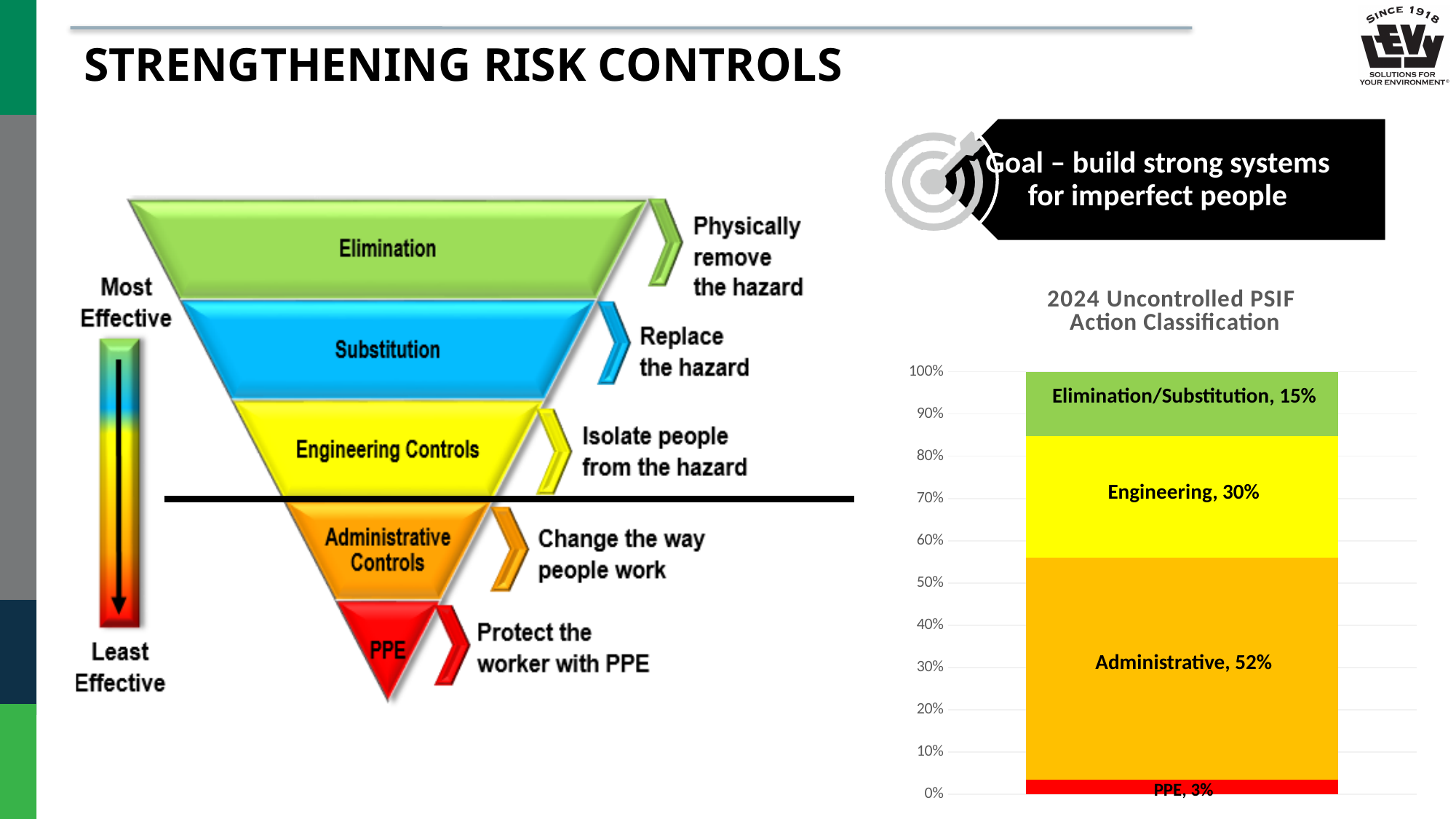
In the 2024 Uncontrolled PSIF Action Classification chart, which segment has the smallest share? PPE In the 2024 Uncontrolled PSIF Action Classification chart, what is the total of the Administrative and PPE segments? 55% What is the title of the chart on the right side of the slide? 2024 Uncontrolled PSIF Action Classification In the 2024 Uncontrolled PSIF Action Classification chart, which segment has the largest share? Administrative In the 2024 Uncontrolled PSIF Action Classification chart, what percentage is Elimination/Substitution? 15% In the 2024 Uncontrolled PSIF Action Classification chart, what is the difference between the Administrative and Engineering percentages? 22% How many segments make up the stacked bar in the 2024 Uncontrolled PSIF Action Classification chart? 4 In the 2024 Uncontrolled PSIF Action Classification chart, which is larger, Engineering or Elimination/Substitution? Engineering In the 2024 Uncontrolled PSIF Action Classification chart, what percentage is Administrative? 52% What type of chart is the 2024 Uncontrolled PSIF Action Classification chart? Stacked bar chart In the 2024 Uncontrolled PSIF Action Classification chart, what percentage is Engineering? 30% In the 2024 Uncontrolled PSIF Action Classification chart, what percentage is PPE? 3%